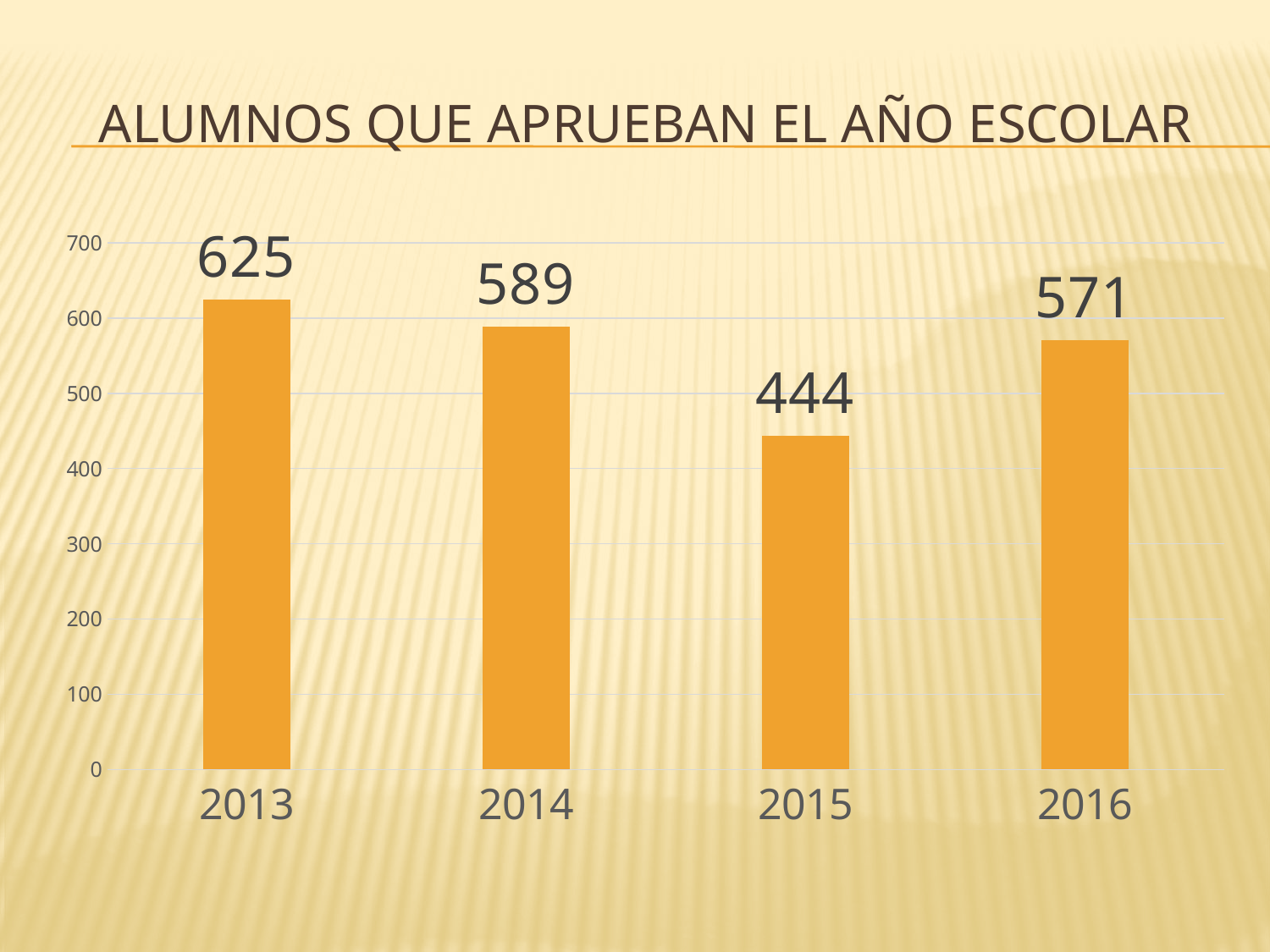
What is the value for 2016? 571 What is the title of the slide? ALUMNOS QUE APRUEBAN EL AÑO ESCOLAR Which year has the lowest value? 2015 How many years are shown on the x axis? 4 What is the value for 2013? 625 Is the value for 2015 greater or less than 500? less What is the difference between the values for 2013 and 2015? 181 What is the difference between the values for 2014 and 2016? 18 What is the value for 2015? 444 What kind of chart is shown on the slide? bar chart Which is larger, the value for 2014 or the value for 2016? 2014 Which year has the highest value? 2013